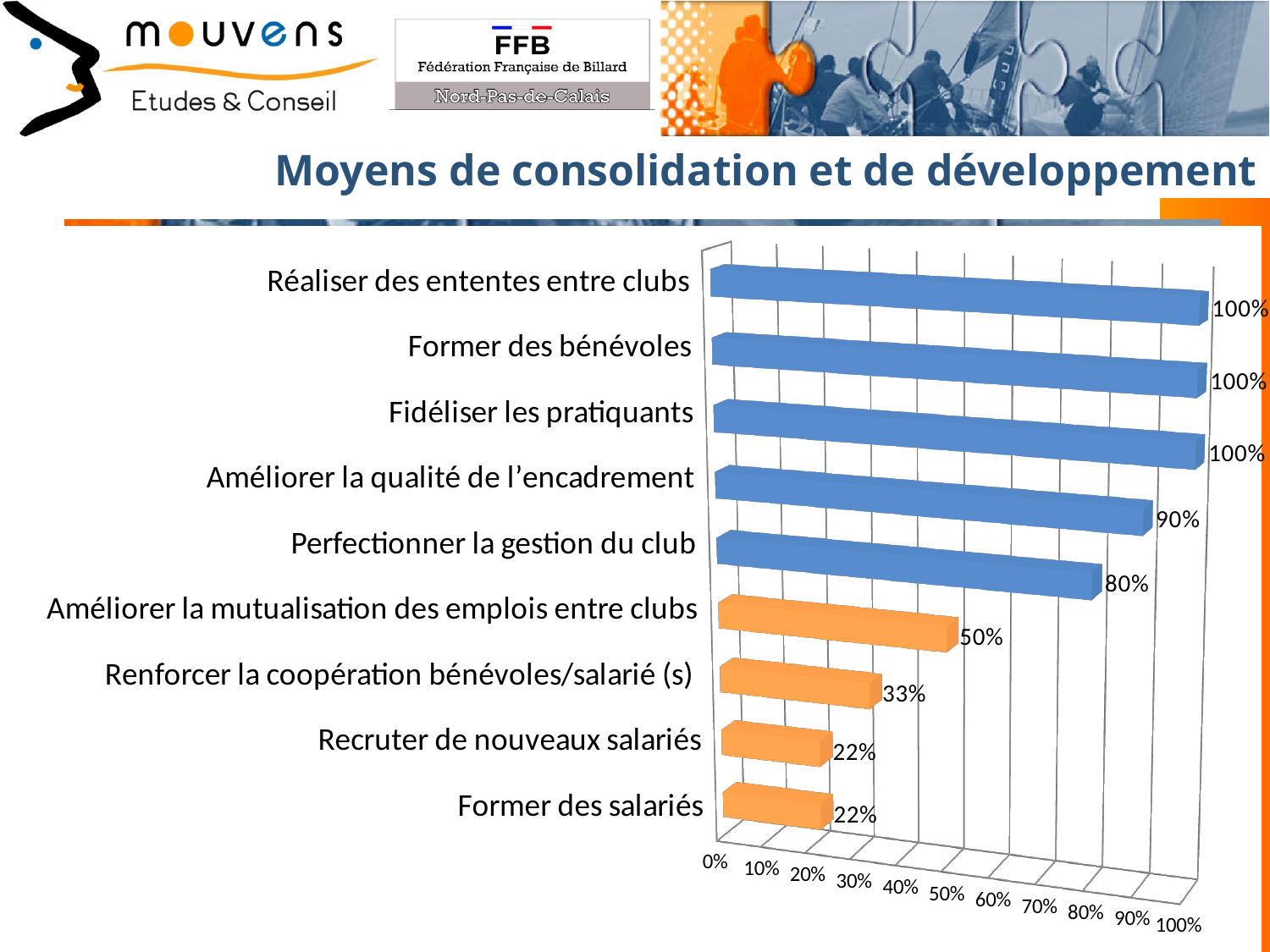
What is the value for "Former des salariés"? 22% What is the value for "Perfectionner la gestion du club"? 80% What is the difference between the values for "Améliorer la qualité de l'encadrement" and "Perfectionner la gestion du club"? 10% How many categories are shown in the chart? 9 Which category has the lowest value, "Perfectionner la gestion du club" or "Recruter de nouveaux salariés"? Recruter de nouveaux salariés What is the value for "Améliorer la qualité de l'encadrement"? 90% What is the value for "Améliorer la mutualisation des emplois entre clubs"? 50% What kind of chart is shown on the slide? Bar chart What is the difference between the values for "Améliorer la mutualisation des emplois entre clubs" and "Renforcer la coopération bénévoles/salarié (s)"? 17% What is the value for "Renforcer la coopération bénévoles/salarié (s)"? 33% How many categories have a value of 100%? 3 What colour are the bars for the four lowest categories? Orange